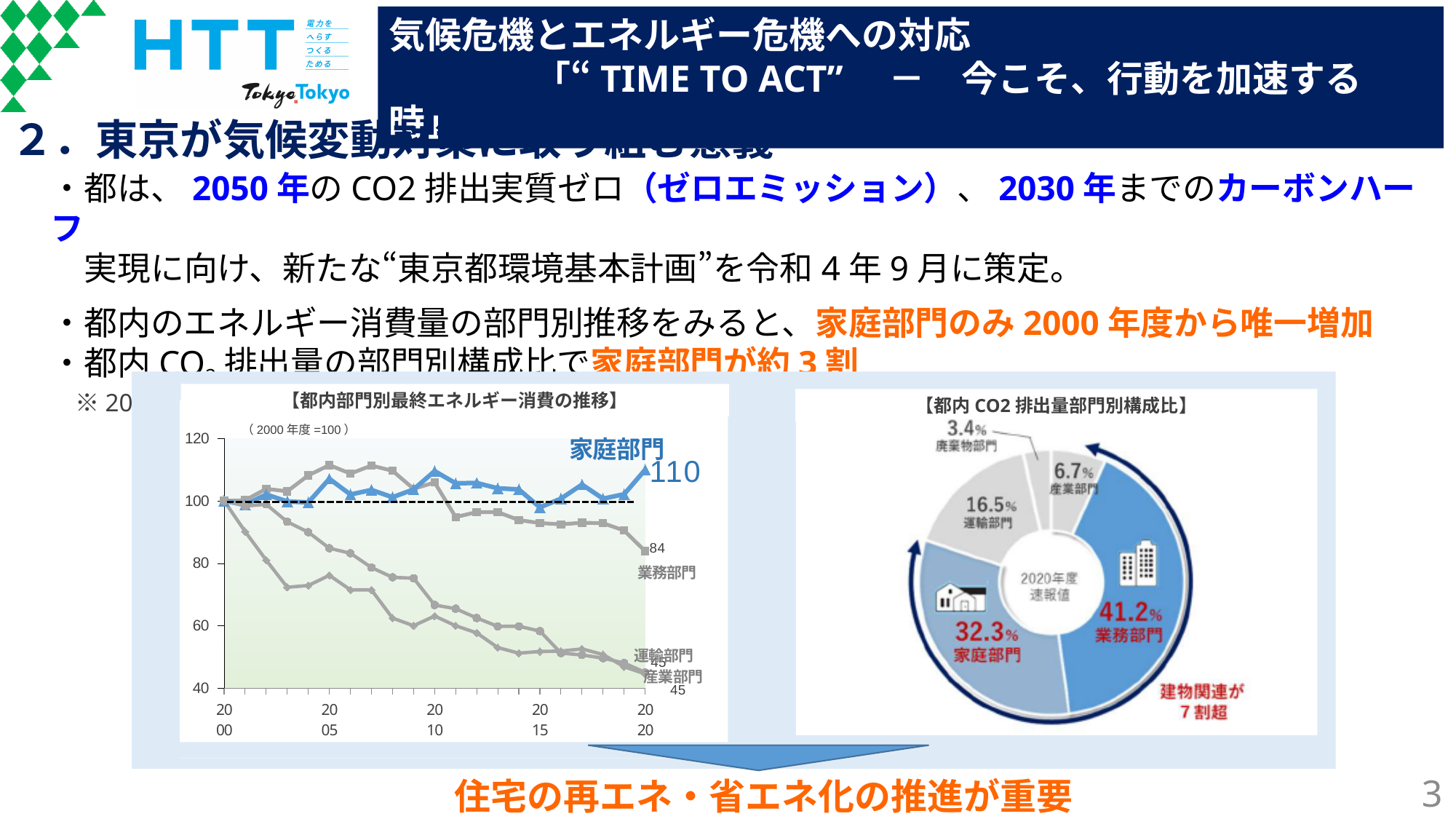
In the line chart 【都内部門別最終エネルギー消費の推移】, does the 業務部門 line rise or fall from 2000 to 2020? fall In the line chart 【都内部門別最終エネルギー消費の推移】, what is the value for 家庭部門 in 2020? 110 In the pie chart 【都内CO2排出量部門別構成比】, what is the combined share of 業務部門 and 家庭部門? 73.5% In the line chart 【都内部門別最終エネルギー消費の推移】, which sector has the highest value in 2020? 家庭部門 In the line chart 【都内部門別最終エネルギー消費の推移】, which base year is set to 100? 2000年度 In the pie chart 【都内CO2排出量部門別構成比】, how many sectors are shown? 5 In the line chart 【都内部門別最終エネルギー消費の推移】, what is the value for 業務部門 in 2020? 84 In the pie chart 【都内CO2排出量部門別構成比】, what is the share of 家庭部門? 32.3% In the pie chart 【都内CO2排出量部門別構成比】, which sector has the largest share? 業務部門 What kind of chart is 【都内CO2排出量部門別構成比】? pie chart In the pie chart 【都内CO2排出量部門別構成比】, which sector has the smallest share? 廃棄物部門 In the line chart 【都内部門別最終エネルギー消費の推移】, what is the difference between the 2020 values of 家庭部門 and 業務部門? 26